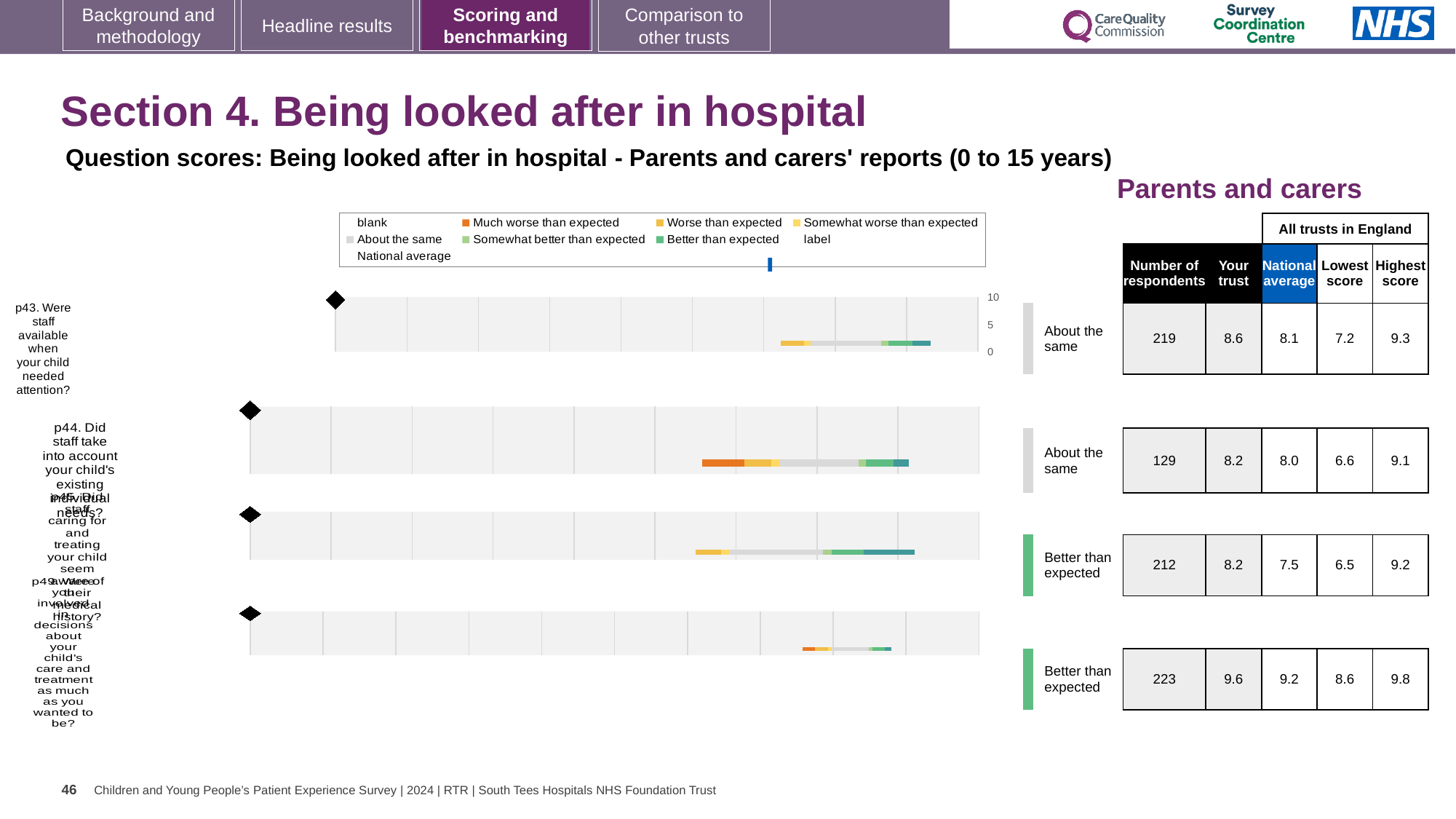
What benchmark category is assigned to the fourth (bottom) row of the chart? Better than expected For the third row of the chart, what is the difference between the 'Your trust' score (8.2) and the national average (7.5)? 0.7 What is the lowest score among all trusts in England for the second row of the chart? 6.6 For the first row, p43, which is larger: the 'Your trust' score or the national average? Your trust (8.6) What is the 'Your trust' score for the first row, p43 (Were staff available when your child needed attention?)? 8.6 What is the national average score for the first row, p43? 8.1 How many question rows (bars) are shown in the benchmark chart? 4 How many respondents are recorded for the fourth (bottom) row of the chart? 223 Which row of the chart has the highest 'Your trust' score? The fourth (bottom) row, p49, with 9.6 What kind of chart is used to show the question scores on this slide? Bar chart What is the highest score among all trusts in England for the third row of the chart? 9.2 Which row of the chart has the lowest 'Lowest score' value? The third row, with 6.5